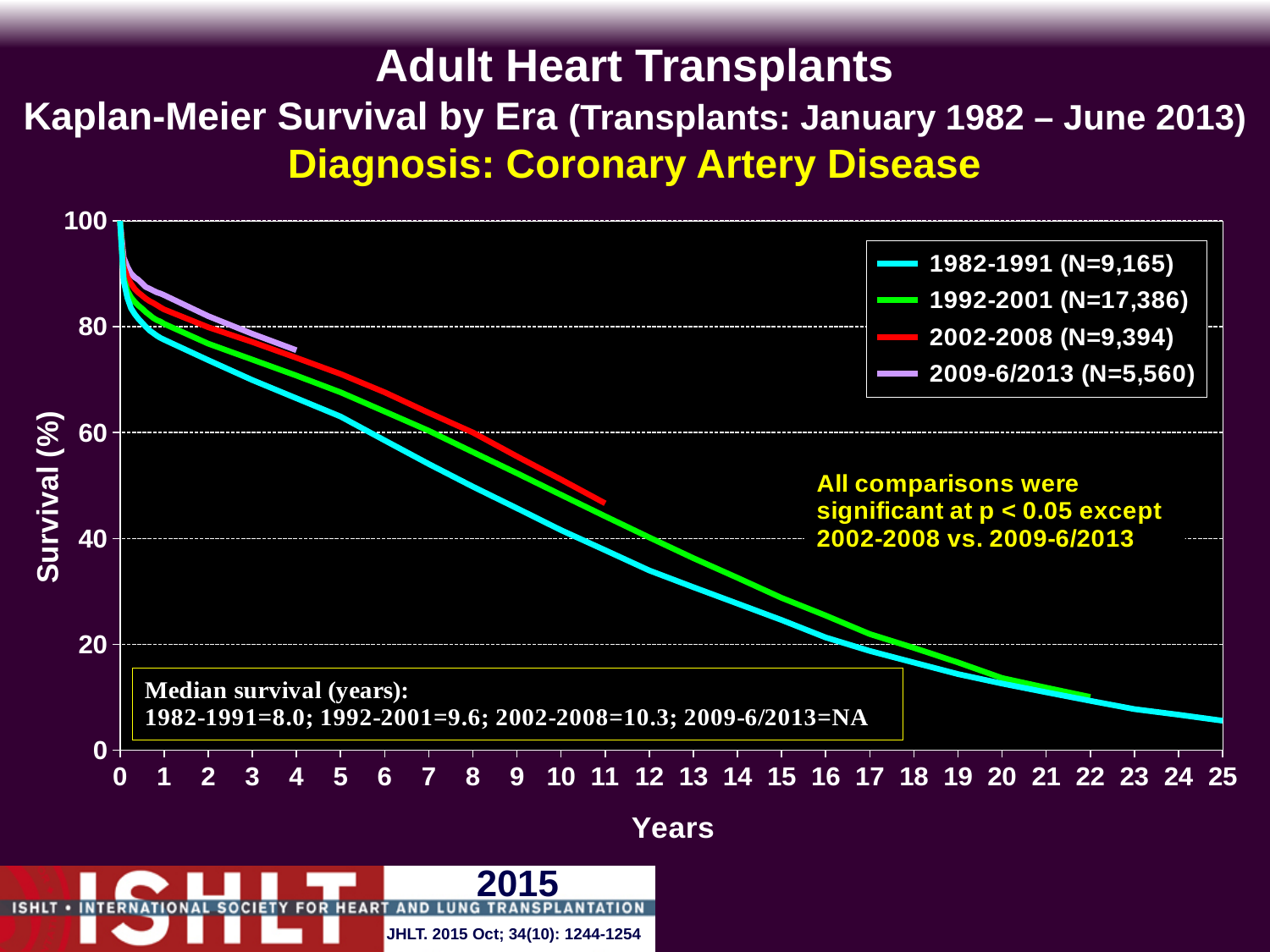
What is the N for the 2009-6/2013 era shown in the legend? 5,560 Is the survival for the 2002-2008 era at 5 years greater or less than 60? greater What is the median survival in years for the 2002-2008 era? 10.3 What is the median survival in years for the 1982-1991 era? 8.0 What kind of chart is shown on the slide? line chart Which era has the highest median survival listed on the slide? 2002-2008 Is the survival for the 1982-1991 era at 10 years greater or less than 60? less Do the survival curves rise or fall as years increase? fall What is the N for the 1992-2001 era shown in the legend? 17,386 How many eras (series) does the legend list? 4 At 5 years, which era has higher survival: 2002-2008 or 1982-1991? 2002-2008 What is the difference in median survival (years) between the 2002-2008 era and the 1982-1991 era? 2.3